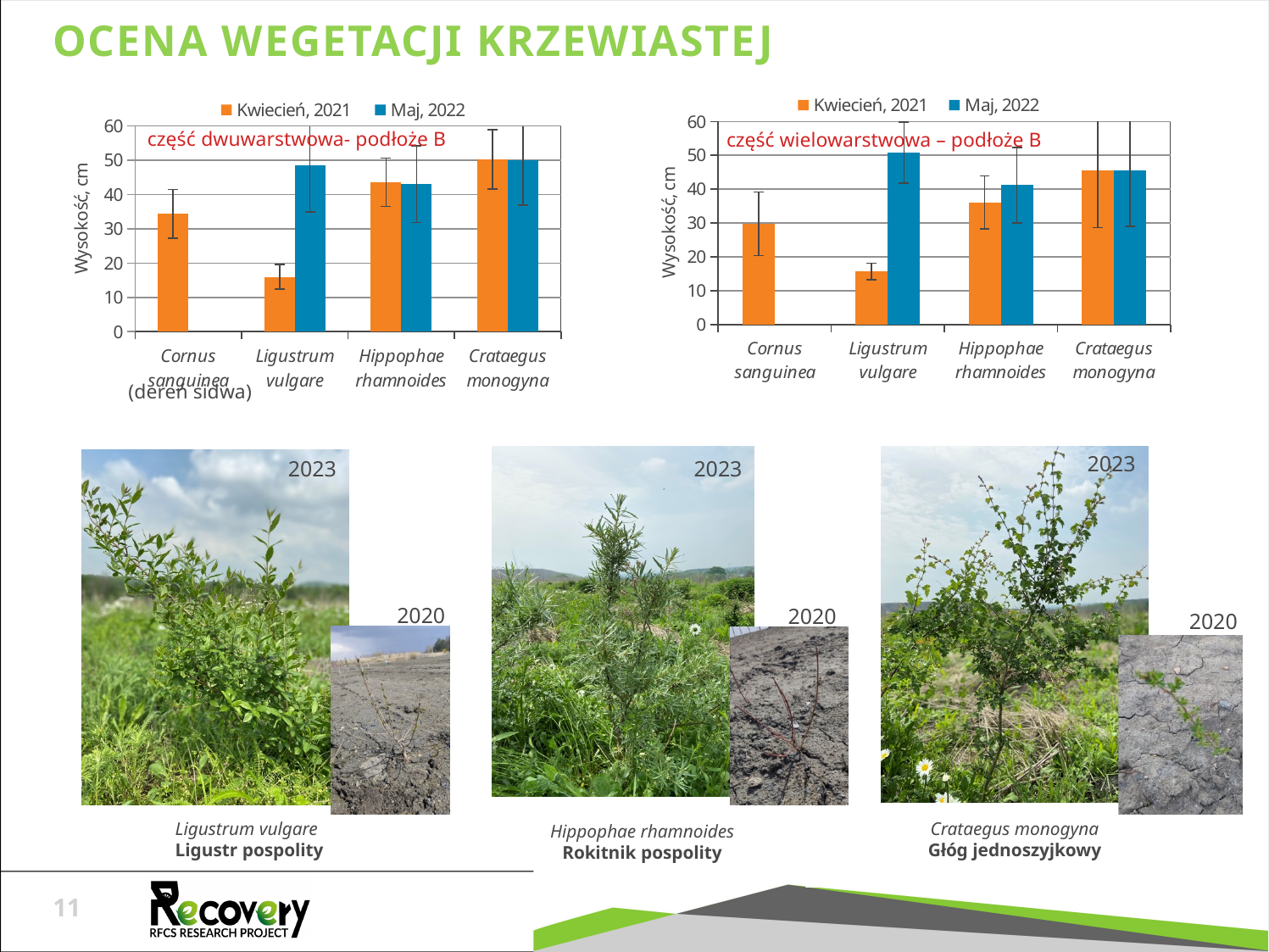
In the chart titled 'część wielowarstwowa – podłoże B', which species has the highest Kwiecień, 2021 value? Crataegus monogyna In the chart titled 'część dwuwarstwowa- podłoże B', which species has no Maj, 2022 bar? Cornus sanguinea In the chart titled 'część wielowarstwowa – podłoże B', for Ligustrum vulgare, which is larger: the Kwiecień, 2021 value or the Maj, 2022 value? Maj, 2022 In the chart titled 'część wielowarstwowa – podłoże B', is the Maj, 2022 value for Ligustrum vulgare greater or less than 40? greater In the chart titled 'część dwuwarstwowa- podłoże B', what kind of chart is shown? bar chart In the chart titled 'część dwuwarstwowa- podłoże B', how many plant species are shown on the x axis? 4 What is the y-axis label of the chart titled 'część wielowarstwowa – podłoże B'? Wysokość, cm In the chart titled 'część wielowarstwowa – podłoże B', is the Kwiecień, 2021 value for Cornus sanguinea greater or less than 40? less In the chart titled 'część dwuwarstwowa- podłoże B', is the Maj, 2022 value for Ligustrum vulgare greater or less than 40? greater In the chart titled 'część wielowarstwowa – podłoże B', how many series does the legend list? 2 In the chart titled 'część dwuwarstwowa- podłoże B', which species has the lowest Kwiecień, 2021 value? Ligustrum vulgare